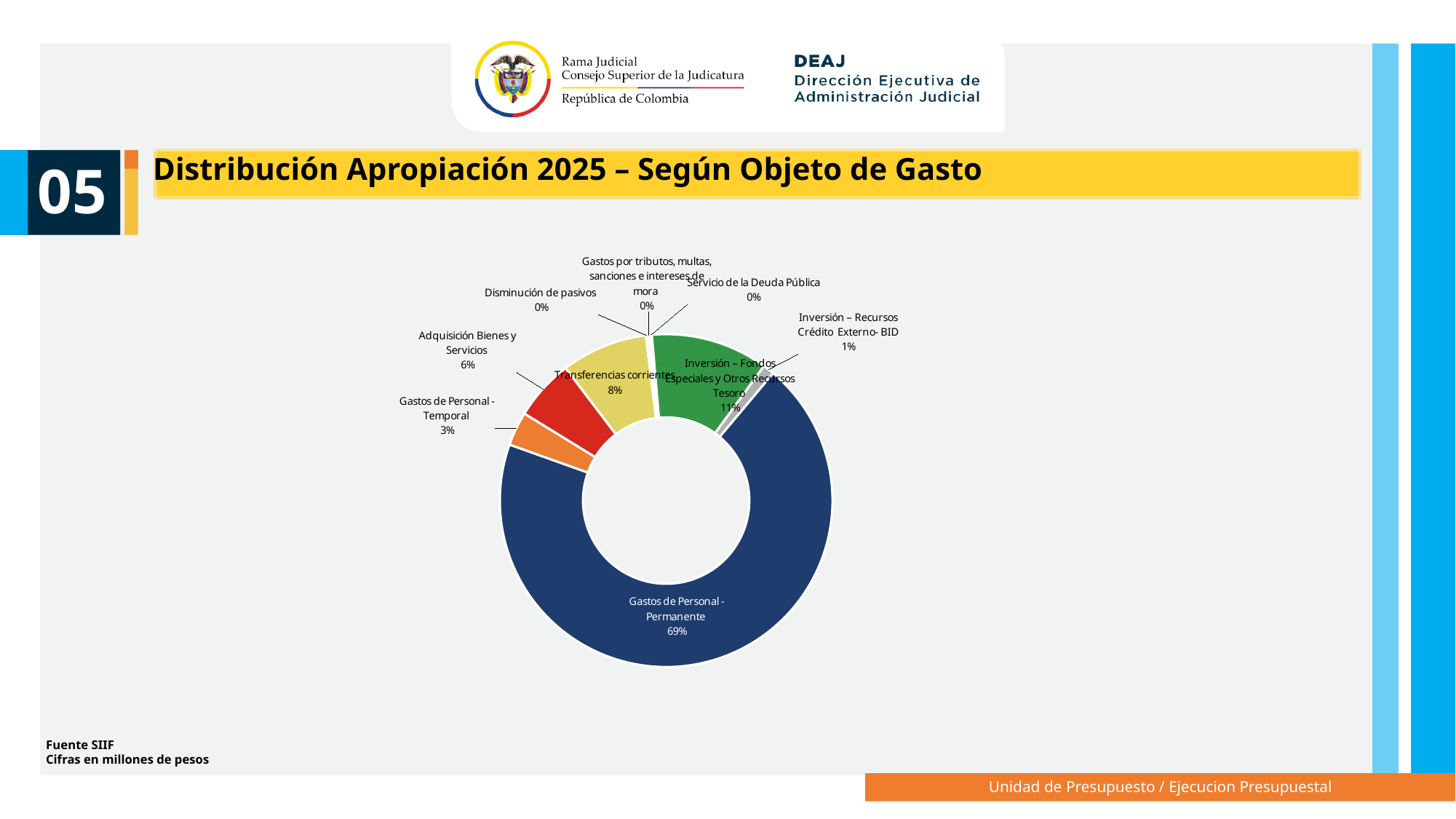
Which category has the largest slice of the chart? Gastos de Personal - Permanente Which is larger, Transferencias corrientes or Adquisición Bienes y Servicios? Transferencias corrientes What is the title of the slide containing the chart? Distribución Apropiación 2025 – Según Objeto de Gasto What is the difference in percentage points between Gastos de Personal - Permanente and Inversión – Fondos Especiales y Otros Recursos Tesoro? 58 percentage points What share of the 2025 appropriation goes to Gastos de Personal - Permanente? 69% What kind of chart is shown on the slide? Pie chart (doughnut) What percentage is shown for Inversión – Recursos Crédito Externo- BID? 1% What percentage is shown for Transferencias corrientes? 8% What percentage is shown for Adquisición Bienes y Servicios? 6% What percentage is shown for Inversión – Fondos Especiales y Otros Recursos Tesoro? 11% What percentage is shown for Gastos de Personal - Temporal? 3% How many categories are shown in the chart? 9